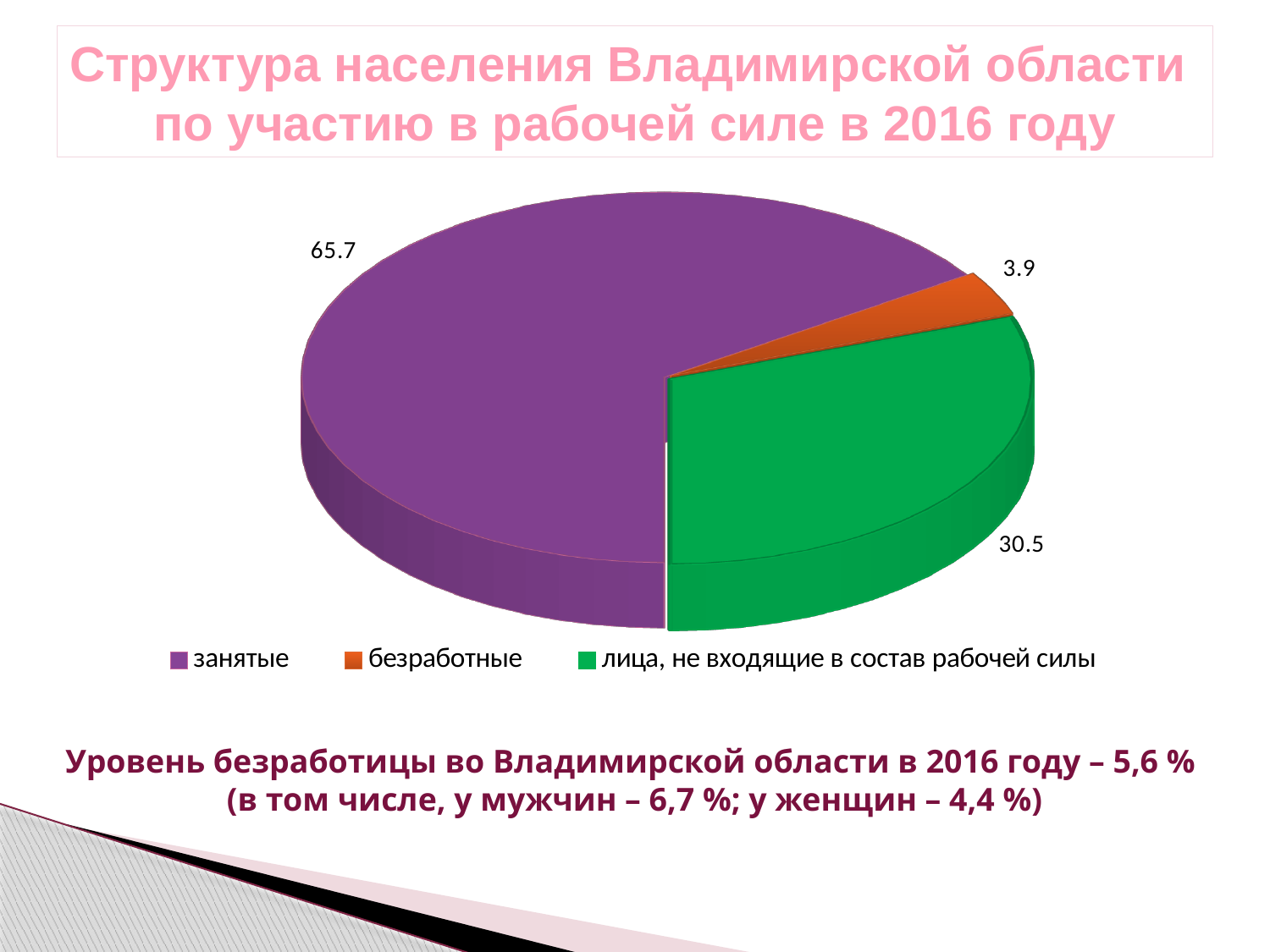
How many slices does the pie chart have? 3 Which category has the smallest slice of the pie chart? безработные What type of chart is shown on the slide? pie chart What is the title of the slide containing the pie chart? Структура населения Владимирской области по участию в рабочей силе в 2016 году Which category has the largest slice of the pie chart? занятые Which is larger: the value for безработные or the value for лица, не входящие в состав рабочей силы? лица, не входящие в состав рабочей силы What is the value for безработные in the pie chart? 3.9 What is the value for занятые in the pie chart? 65.7 What is the difference between the values for лица, не входящие в состав рабочей силы and безработные? 26.6 What is the value for лица, не входящие в состав рабочей силы in the pie chart? 30.5 What is the difference between the values for занятые and лица, не входящие в состав рабочей силы? 35.2 What colour is the slice for безработные in the pie chart? orange